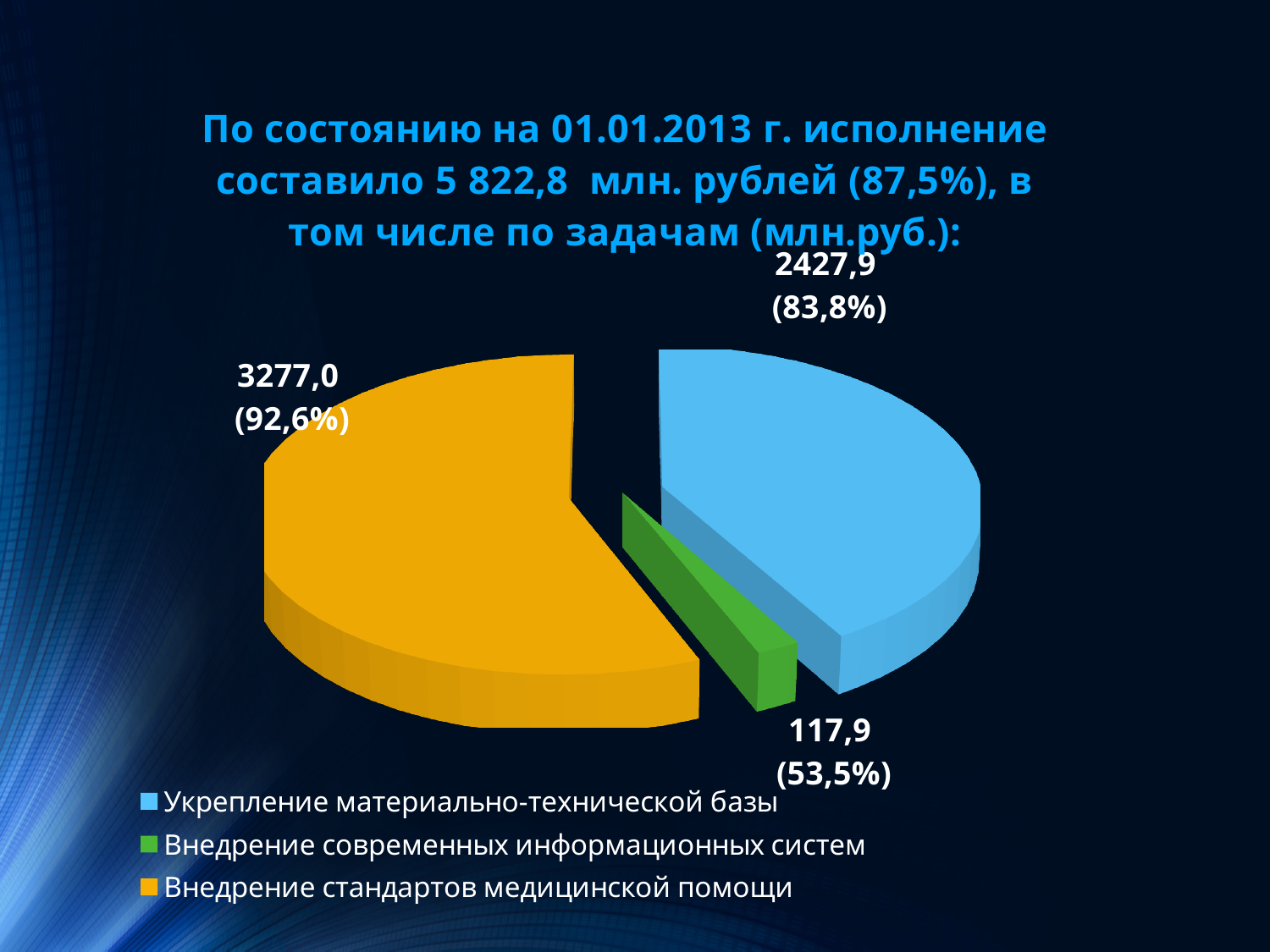
Which category has the smallest value in the pie chart? Внедрение современных информационных систем What value is shown for Укрепление материально-технической базы? 2427,9 What is the difference between the values for Внедрение стандартов медицинской помощи and Укрепление материально-технической базы? 849,1 What percentage is shown in parentheses next to the value for Внедрение стандартов медицинской помощи? 92,6% What value is shown for Внедрение стандартов медицинской помощи? 3277,0 How many entries does the legend list? 3 Which category has the largest value in the pie chart? Внедрение стандартов медицинской помощи How many slices does the pie chart have? 3 Which colour represents Внедрение современных информационных систем in the pie chart? Green What kind of chart is shown on the slide? Pie chart Which is larger: the value for Укрепление материально-технической базы or for Внедрение стандартов медицинской помощи? Внедрение стандартов медицинской помощи What value is shown for Внедрение современных информационных систем? 117,9